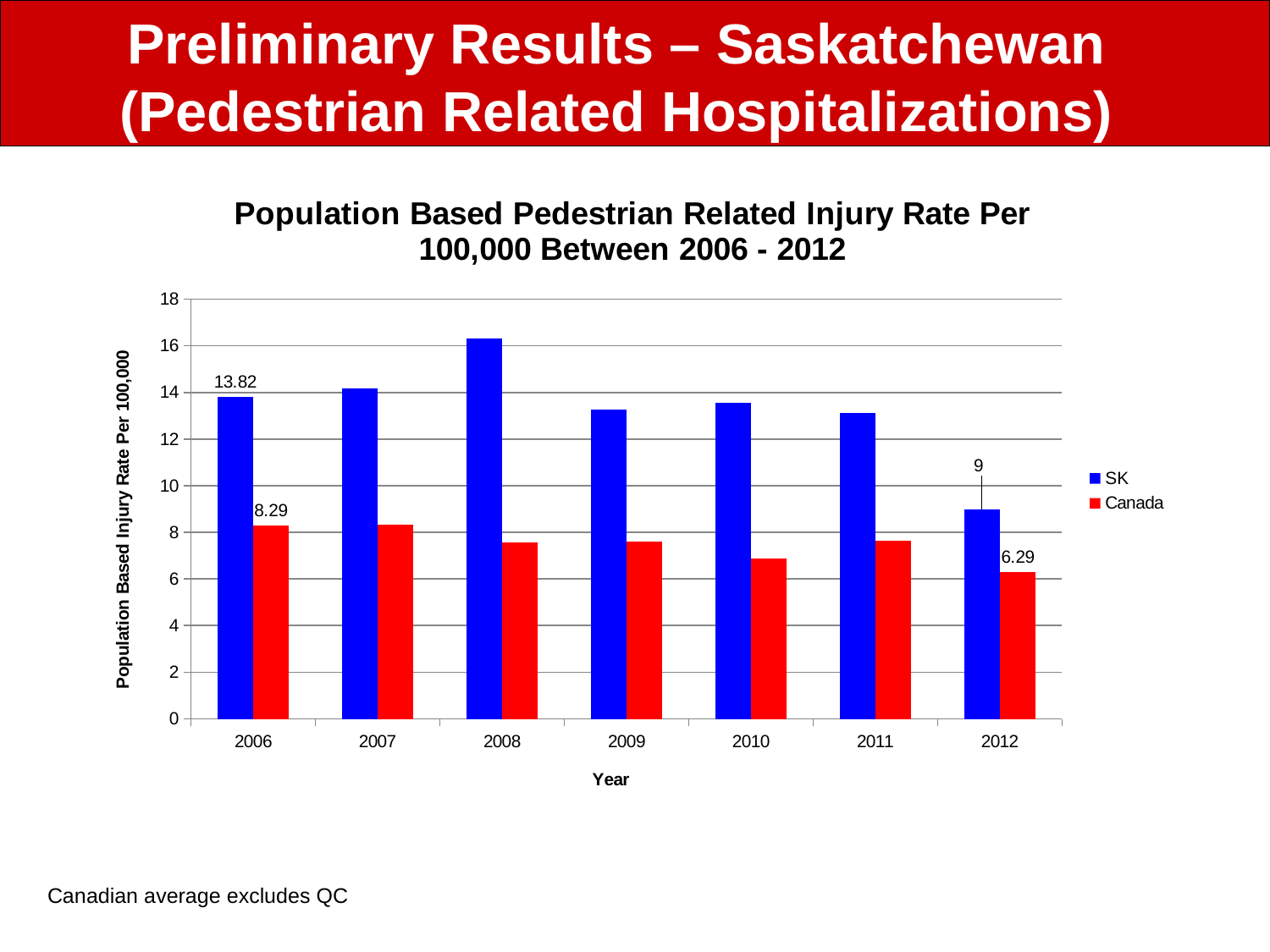
What is the value for Canada in 2006? 8.29 What is the difference between the SK and Canada values in 2012? 2.71 In which year is the SK injury rate lowest? 2012 What is the difference between the SK and Canada values in 2006? 5.53 How many years are shown on the x axis? 7 What is the value for SK in 2012? 9 Is the value for Canada in 2010 greater or less than 8? less In which year is the SK injury rate highest? 2008 What kind of chart is shown on the slide? bar chart How many series does the legend list? 2 What is the value for Canada in 2012? 6.29 What is the value for SK in 2006? 13.82